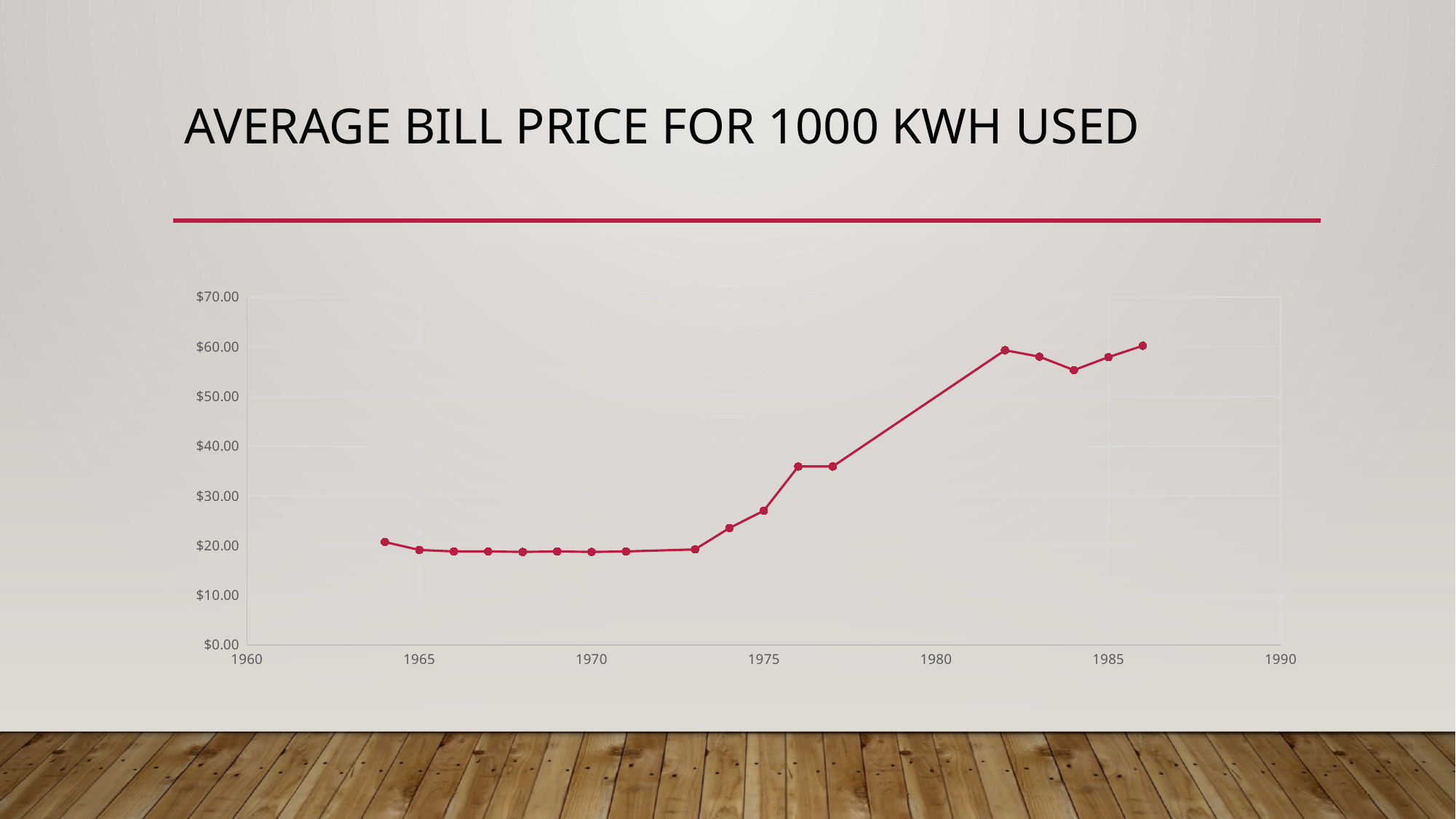
Which year has the larger value, 1983 or 1984? 1983 What is the highest value shown on the vertical axis? $70.00 Is the value for 1984 greater or less than $50.00? greater Which year has the larger value, 1977 or 1982? 1982 Is the value for 1975 greater or less than $30.00? less How many data points are plotted on the line? 18 What is the title of the chart? Average Bill Price for 1000 kWh Used Is the value for 1970 greater or less than $20.00? less Overall, do the values rise or fall from 1964 to 1986? rise What kind of chart is shown on the slide? line chart